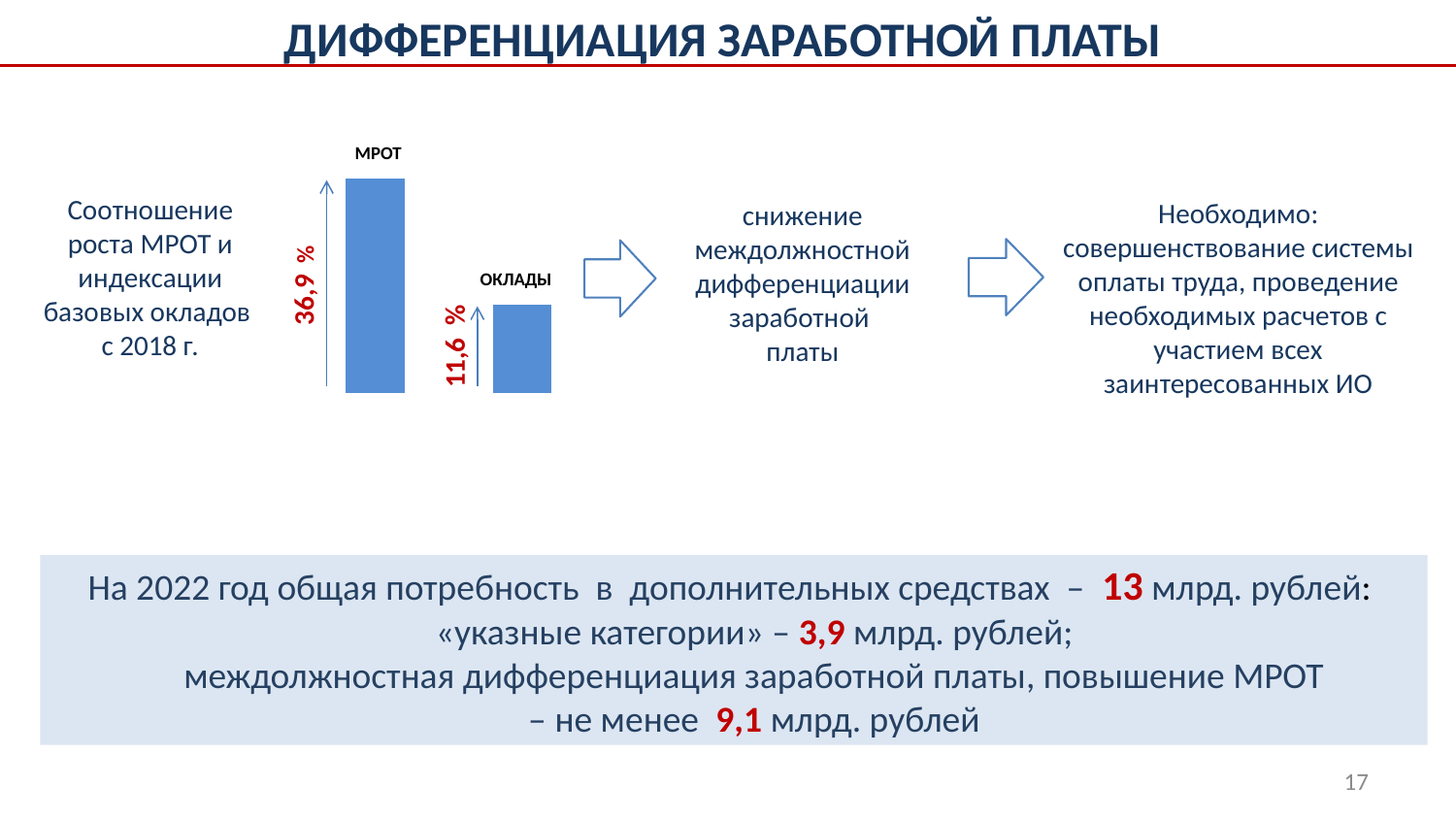
Is the value for МРОТ larger or smaller than the value for ОКЛАДЫ? larger How many bars are shown in the chart? 2 What kind of chart is shown on the slide? bar chart What is the difference between the МРОТ value and the ОКЛАДЫ value in the chart? 25,3 % What colour are the bars in the chart? blue What is the title of the slide containing the bar chart? ДИФФЕРЕНЦИАЦИЯ ЗАРАБОТНОЙ ПЛАТЫ Which category has the higher bar in the chart, МРОТ or ОКЛАДЫ? МРОТ What is the value shown for ОКЛАДЫ in the bar chart? 11,6 % What is the value shown for МРОТ in the bar chart? 36,9 % Which category has the lowest value in the bar chart? ОКЛАДЫ